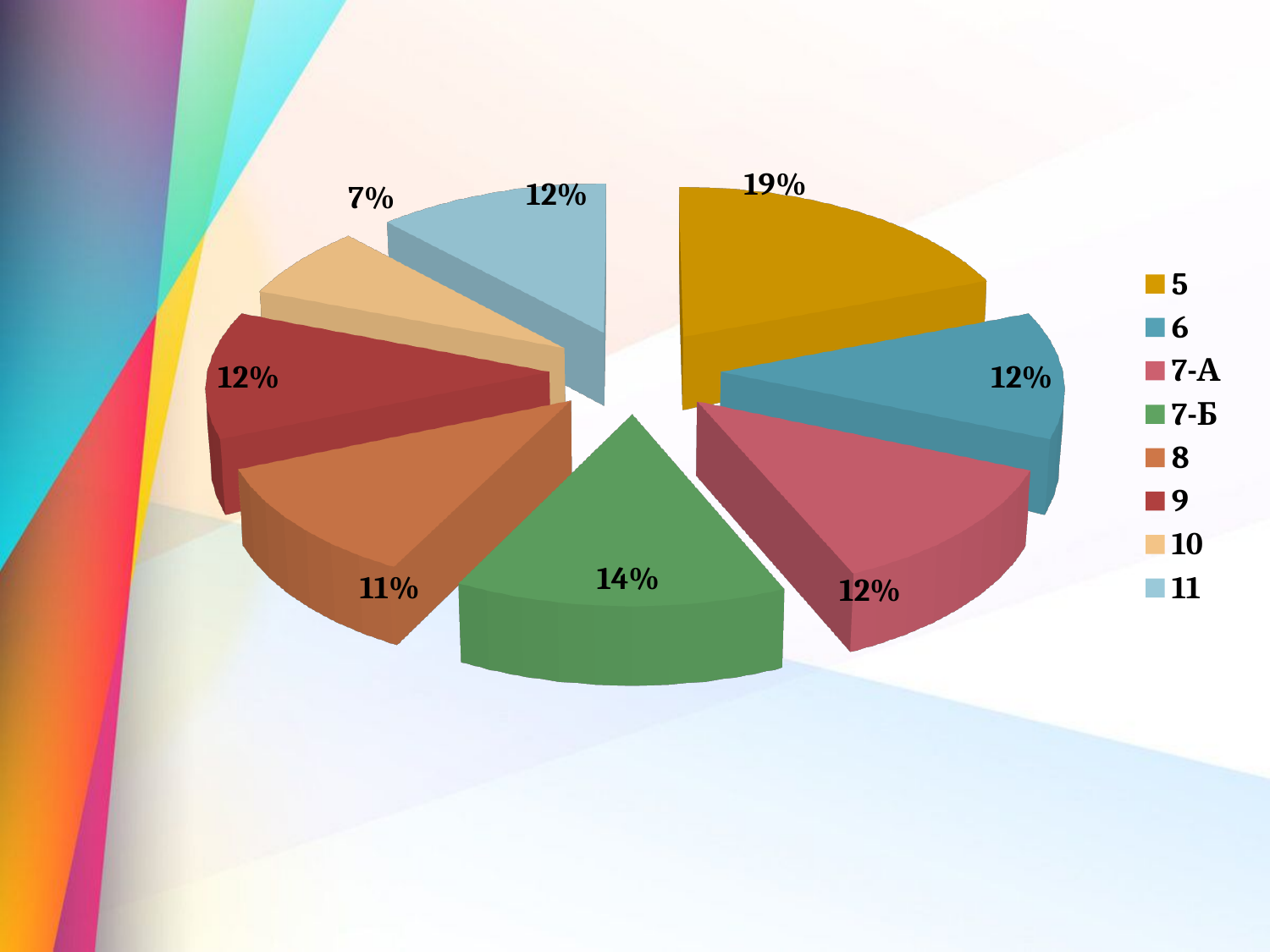
What share of the pie does category 5 have? 19% Which category has the largest slice of the pie? 5 Which is larger, the value for category 7-Б or the value for category 8? 7-Б Which category has the smallest slice of the pie? 10 What is the value shown for category 8? 11% What is the difference between the values for category 5 and category 10? 12% How many categories does the pie chart have? 8 What is the value shown for category 7-Б? 14% What is the value shown for category 10? 7% What kind of chart is shown on the slide? pie chart What colour is the slice for category 7-Б in the legend? green What is the value shown for category 6? 12%